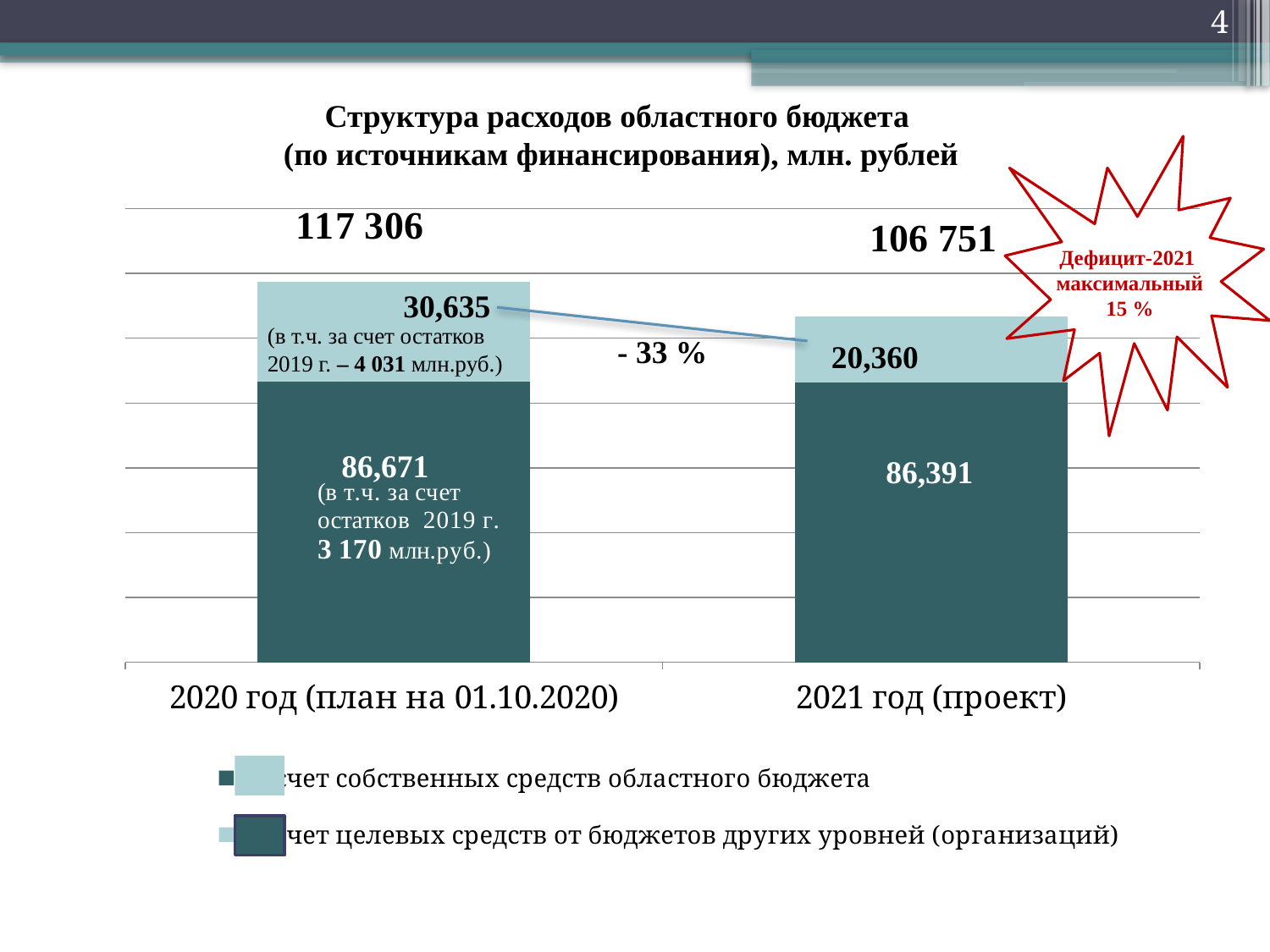
How many series does the legend list? 2 What is the total of the stacked bar for 2020 год (план на 01.10.2020)? 117 306 What is the value of the dark lower segment of the bar for 2020 год (план на 01.10.2020)? 86,671 What is the value of the dark lower segment of the bar for 2021 год (проект)? 86,391 Do the bar totals rise or fall from 2020 год to 2021 год? fall What percentage change is printed between the upper segments of the two bars? - 33 % How many categories (years) are plotted on the x axis? 2 What is the total of the stacked bar for 2021 год (проект)? 106 751 What is the value of the light-coloured upper segment of the bar for 2020 год (план на 01.10.2020)? 30,635 By how much does the total for 2020 год exceed the total for 2021 год? 10 555 Which year has the larger light-coloured upper segment, 2020 год or 2021 год? 2020 год What kind of chart is shown on the slide? bar chart